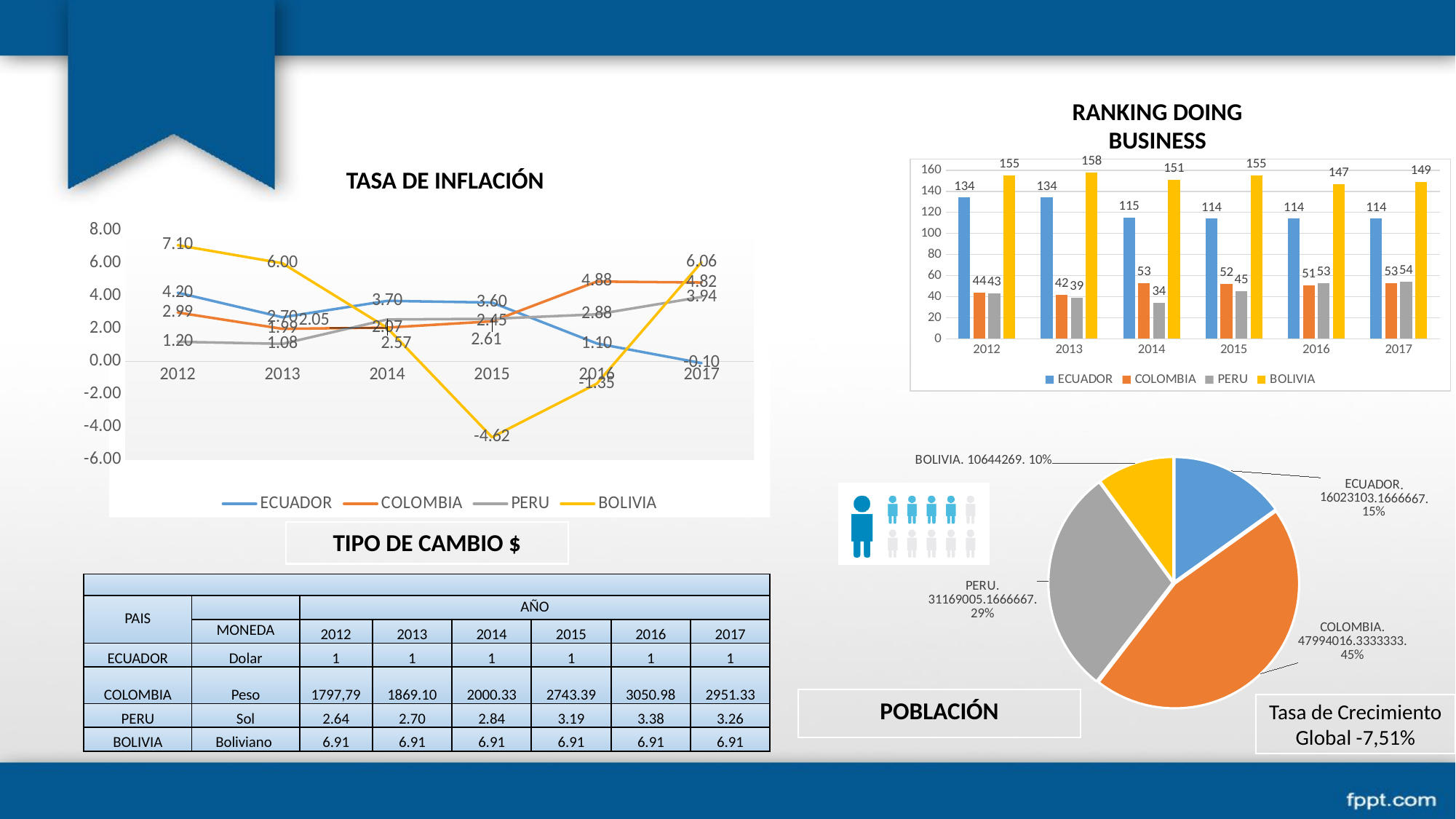
In the TASA DE INFLACIÓN chart, which country has the lowest value in 2015? BOLIVIA In the RANKING DOING BUSINESS chart, what is the difference between ECUADOR's value in 2012 and in 2014? 19 In the RANKING DOING BUSINESS chart, what is the value for BOLIVIA in 2013? 158 In the POBLACIÓN pie chart, what share does COLOMBIA have? 45% What kind of chart is the RANKING DOING BUSINESS chart? Bar chart In the TASA DE INFLACIÓN chart, does the ECUADOR line rise or fall from 2014 to 2017? Fall How many series does the legend of the RANKING DOING BUSINESS chart list? 4 What kind of chart is the TASA DE INFLACIÓN chart? Line chart In the RANKING DOING BUSINESS chart, which country has the highest value in 2014? BOLIVIA In the RANKING DOING BUSINESS chart, how many years are shown on the x axis? 6 In the POBLACIÓN pie chart, which country has the largest slice? COLOMBIA In the TASA DE INFLACIÓN chart, what is the value for BOLIVIA in 2015? -4.62